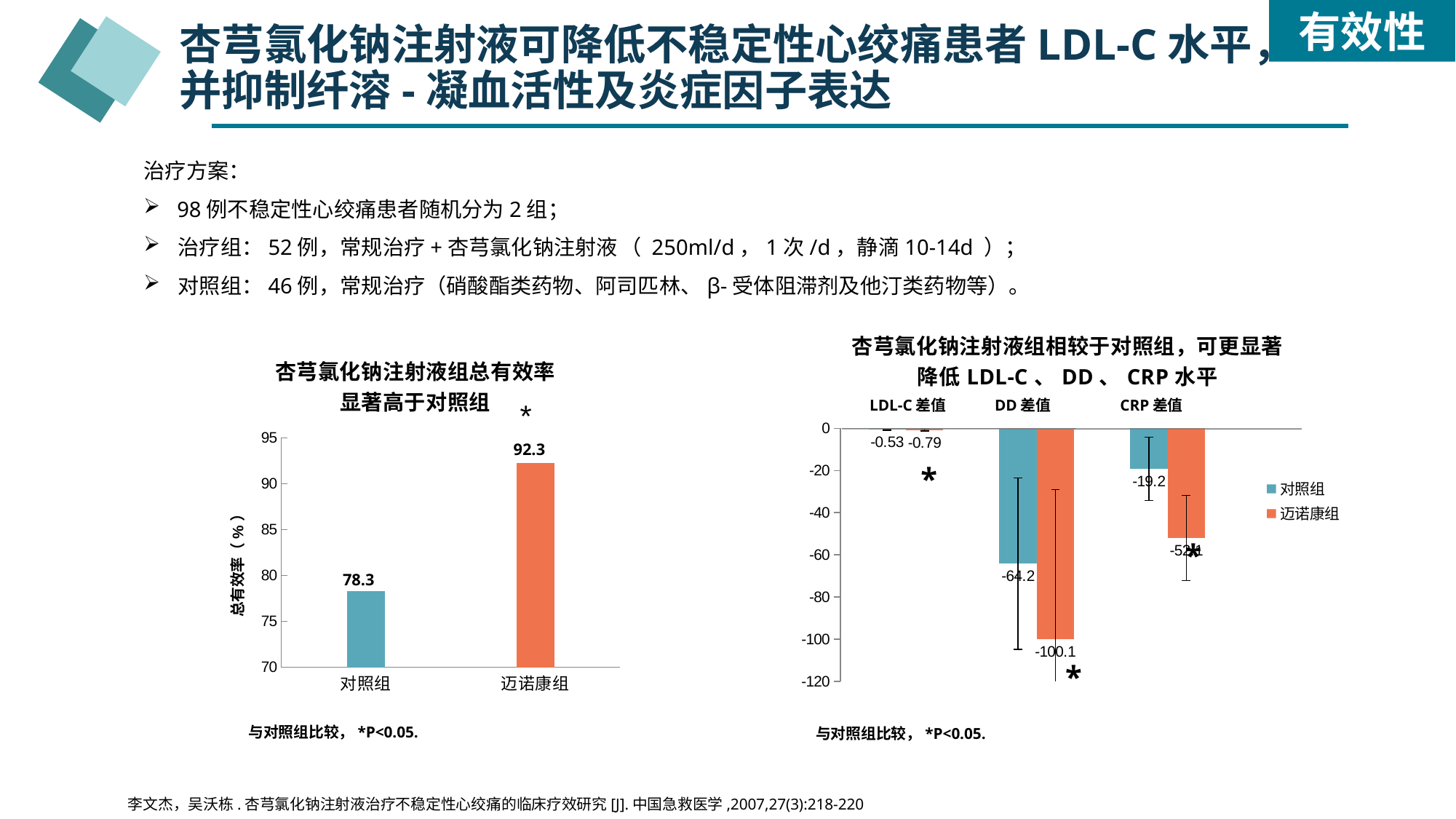
In the left chart, which group has the higher 总有效率? 迈诺康组 In the right chart, what is the 对照组 value for DD 差值? -64.2 In the left chart, what is the difference between the 迈诺康组 and 对照组 values? 14 What kind of chart is the left chart? bar chart In the right chart, what is the 对照组 value for CRP 差值? -19.2 In the right chart, what is the 迈诺康组 value for DD 差值? -100.1 How many series does the legend of the right chart list? 2 In the right chart, is the 迈诺康组 value for CRP 差值 greater or less than -40? less In the left chart (杏芎氯化钠注射液组总有效率显著高于对照组), what is the value for 迈诺康组? 92.3 In the right chart, what is the 迈诺康组 value for LDL-C 差值? -0.79 In the left chart (杏芎氯化钠注射液组总有效率显著高于对照组), what is the value for 对照组? 78.3 How many categories are shown on the x axis of the right chart? 3